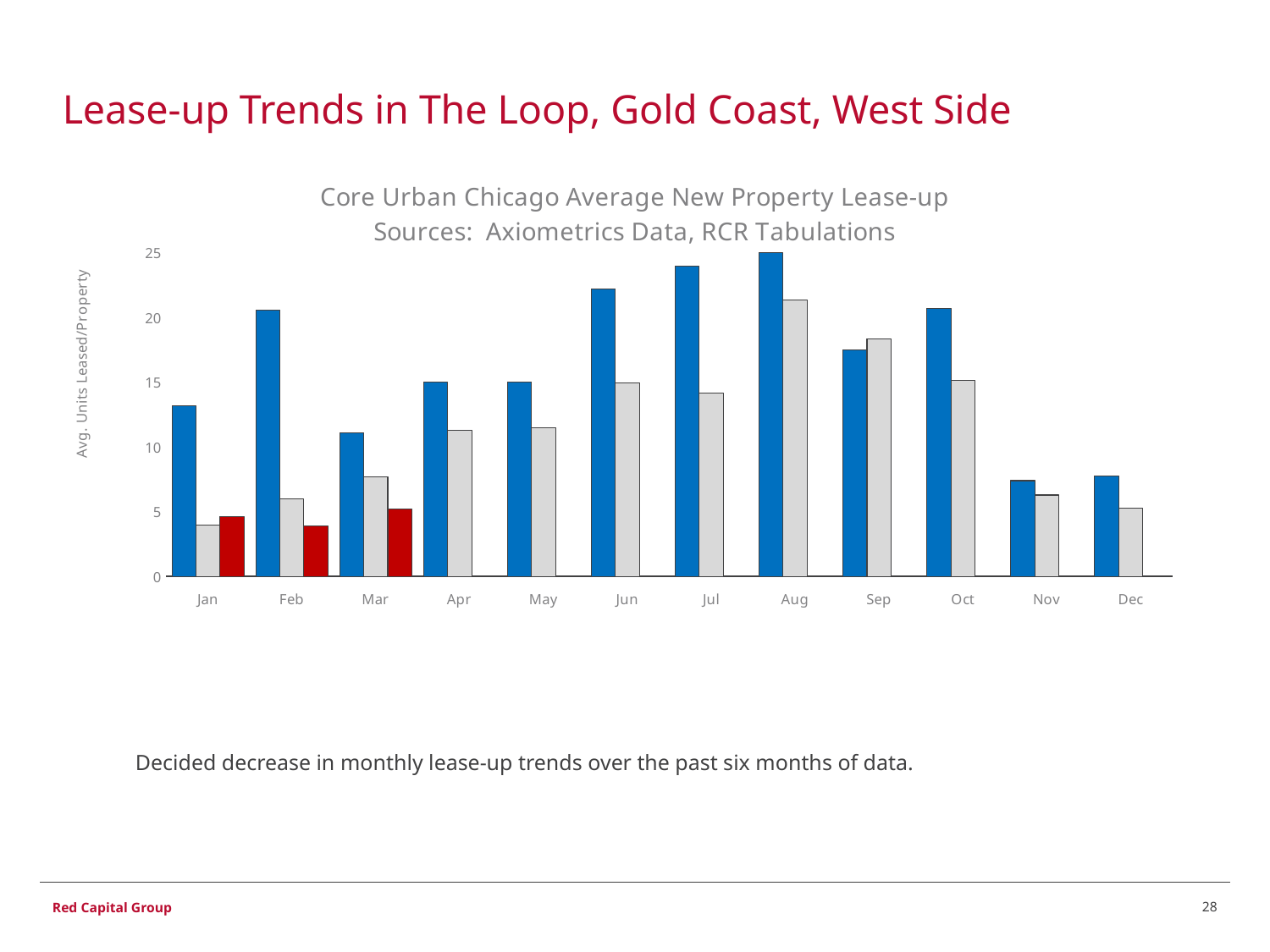
In which month is the gray bar the shortest? Jan Is the value of the gray bar for Jan greater or less than 5? less Is the value of the blue bar for Mar greater or less than 15? less In which month is the gray bar the tallest? Aug Is the value of the blue bar for Jul greater or less than 20? greater Do the blue bars rise or fall from Aug to Dec? Fall What is the label on the y axis of the chart? Avg. Units Leased/Property What type of chart is shown on the slide? Bar chart In which month is the blue bar the tallest? Aug In Jun, which bar is taller, the blue bar or the gray bar? The blue bar How many months are shown on the x axis of the chart? 12